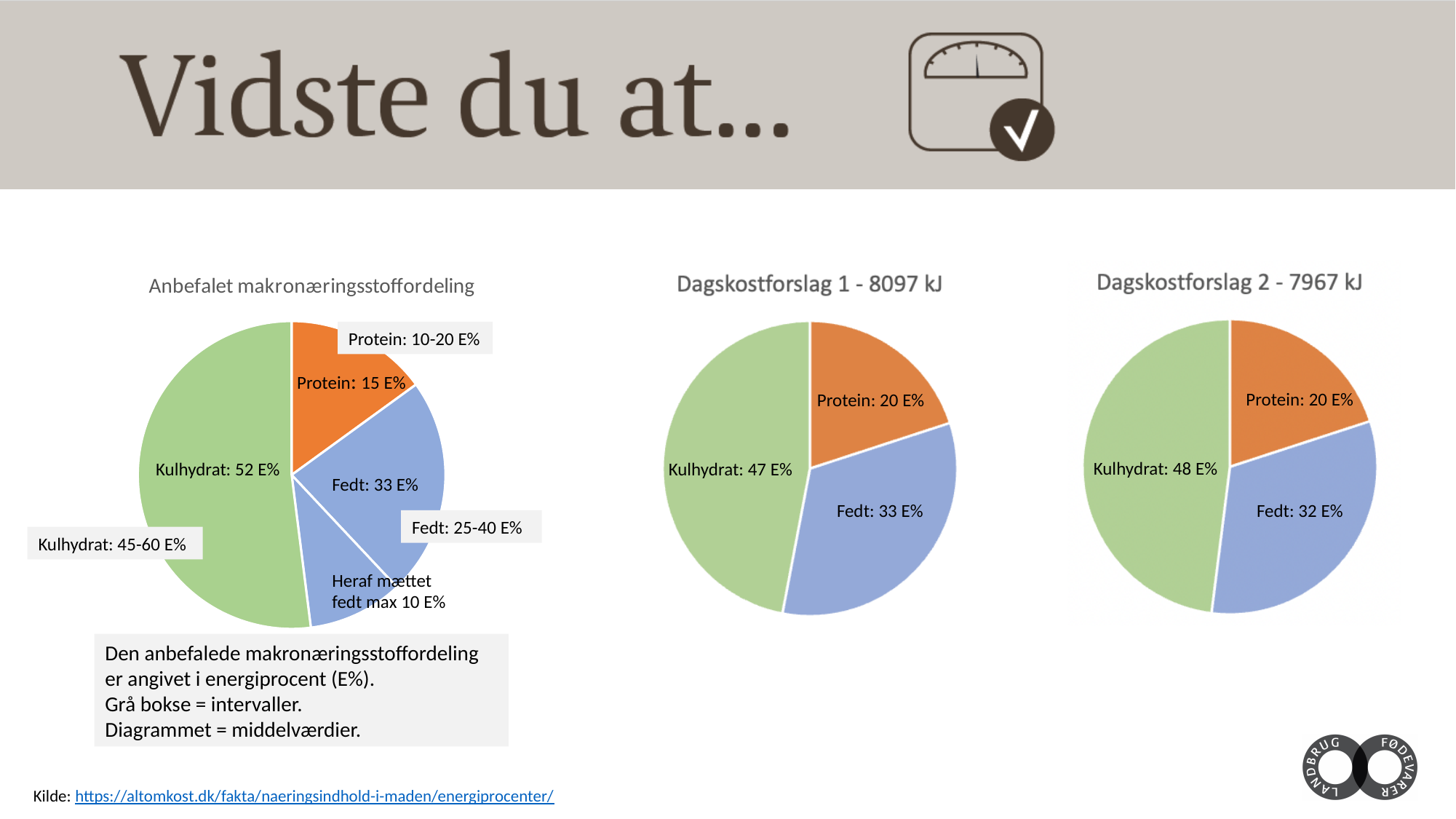
In the 'Dagskostforslag 2 - 7967 kJ' chart, what is the difference between Fedt and Protein? 12 E% In the 'Dagskostforslag 1 - 8097 kJ' chart, which category has the smallest share? Protein In the 'Anbefalet makronæringsstoffordeling' chart, what is the recommended interval shown for Fedt? 25-40 E% In the 'Dagskostforslag 2 - 7967 kJ' chart, what is the value for Kulhydrat? 48 E% In the 'Dagskostforslag 2 - 7967 kJ' chart, which category has the largest share? Kulhydrat In the 'Dagskostforslag 1 - 8097 kJ' chart, what is the value for Fedt? 33 E% What kind of chart is 'Dagskostforslag 1 - 8097 kJ'? Pie chart How many pie charts are shown on the slide? 3 In the 'Anbefalet makronæringsstoffordeling' chart, what is the value for Kulhydrat? 52 E% Which is larger in the 'Dagskostforslag 1 - 8097 kJ' chart: Kulhydrat or Fedt? Kulhydrat In the 'Anbefalet makronæringsstoffordeling' chart, what is the value for Protein? 15 E% In the 'Anbefalet makronæringsstoffordeling' chart, what is the difference between Kulhydrat and Fedt? 19 E%